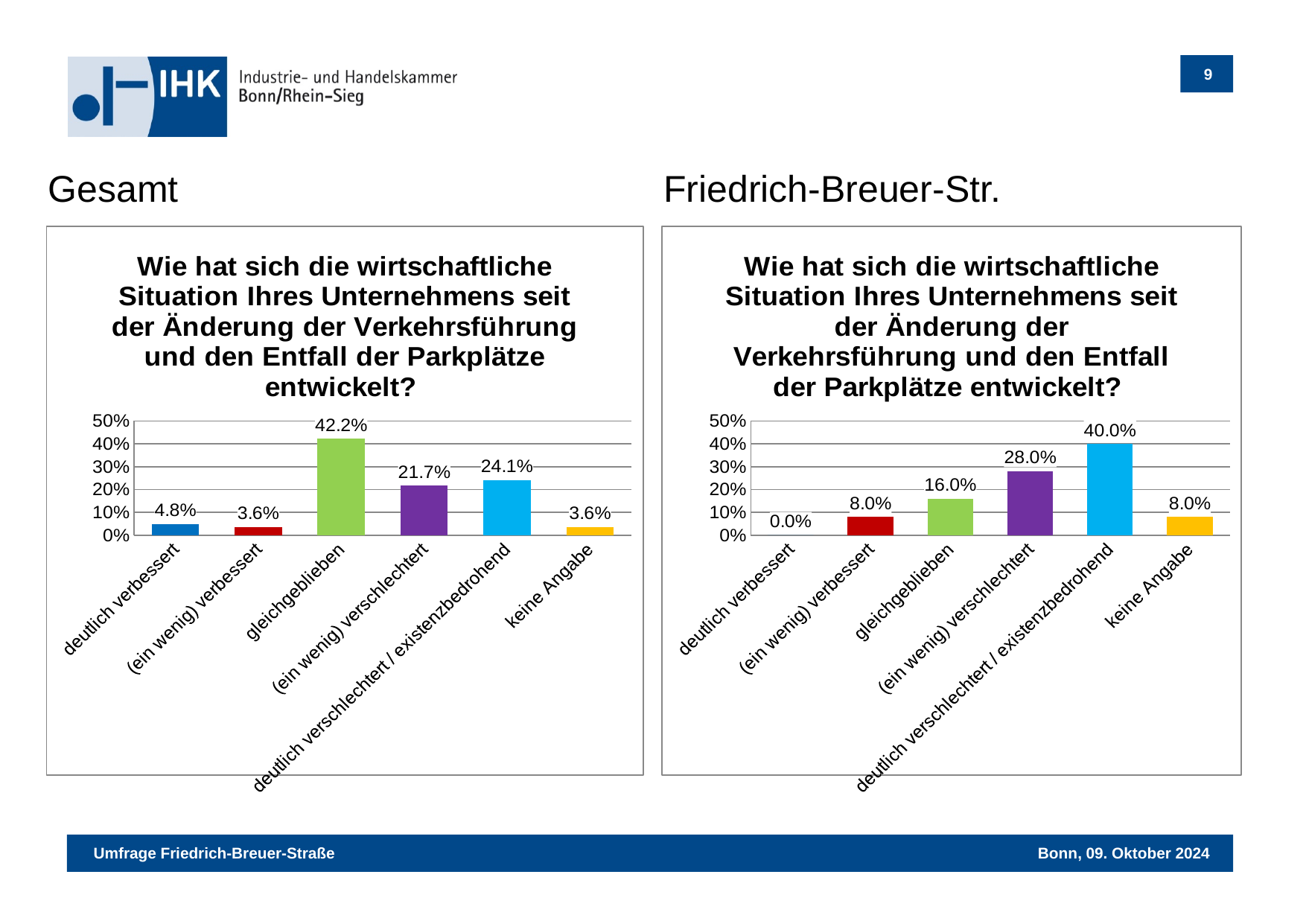
In the Gesamt chart on the left, what is the value for "gleichgeblieben"? 42.2% In the Friedrich-Breuer-Str. chart on the right, is the value for "(ein wenig) verschlechtert" greater or less than 20%? greater In the Friedrich-Breuer-Str. chart on the right, which category has the lowest value? deutlich verbessert How many categories are shown in the Gesamt chart on the left? 6 In the Friedrich-Breuer-Str. chart on the right, what is the value for "keine Angabe"? 8.0% In the Friedrich-Breuer-Str. chart on the right, what is the value for "deutlich verschlechtert / existenzbedrohend"? 40.0% In the Gesamt chart on the left, what is the difference between "deutlich verschlechtert / existenzbedrohend" and "(ein wenig) verschlechtert"? 2.4% In the Friedrich-Breuer-Str. chart on the right, what is the difference between "deutlich verschlechtert / existenzbedrohend" and "(ein wenig) verschlechtert"? 12.0% In the Gesamt chart on the left, which category has the highest value? gleichgeblieben In the Gesamt chart on the left, what colour is the bar for "gleichgeblieben"? green In the Gesamt chart on the left, which is larger: "deutlich verbessert" or "(ein wenig) verbessert"? deutlich verbessert What kind of chart is the Friedrich-Breuer-Str. chart on the right? bar chart